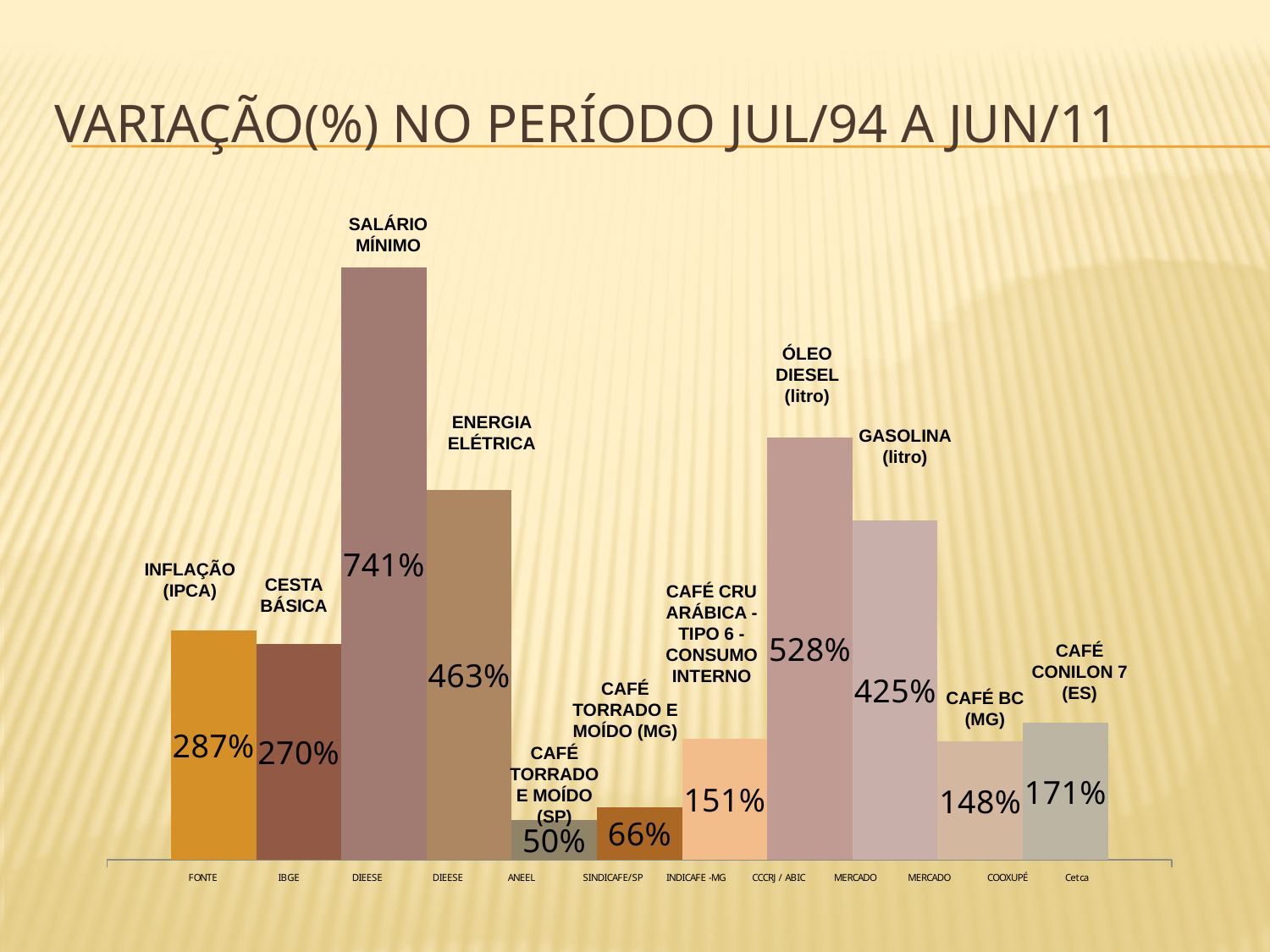
What is the value shown for GASOLINA (litro)? 425% Which category has the lowest value? CAFÉ TORRADO E MOÍDO (SP) What is the difference between the values for ÓLEO DIESEL (litro) and GASOLINA (litro)? 103% What kind of chart is shown on the slide? Bar chart What is the title of the chart? VARIAÇÃO(%) NO PERÍODO JUL/94 A JUN/11 Which is larger, the value for ENERGIA ELÉTRICA or the value for ÓLEO DIESEL (litro)? ÓLEO DIESEL (litro) What is the difference between the values for INFLAÇÃO (IPCA) and CESTA BÁSICA? 17% What is the value shown for SALÁRIO MÍNIMO? 741% Which category has the highest value? SALÁRIO MÍNIMO What is the value shown for CAFÉ TORRADO E MOÍDO (SP)? 50% How many bars are plotted in the chart? 11 What is the value shown for CAFÉ CONILON 7 (ES)? 171%